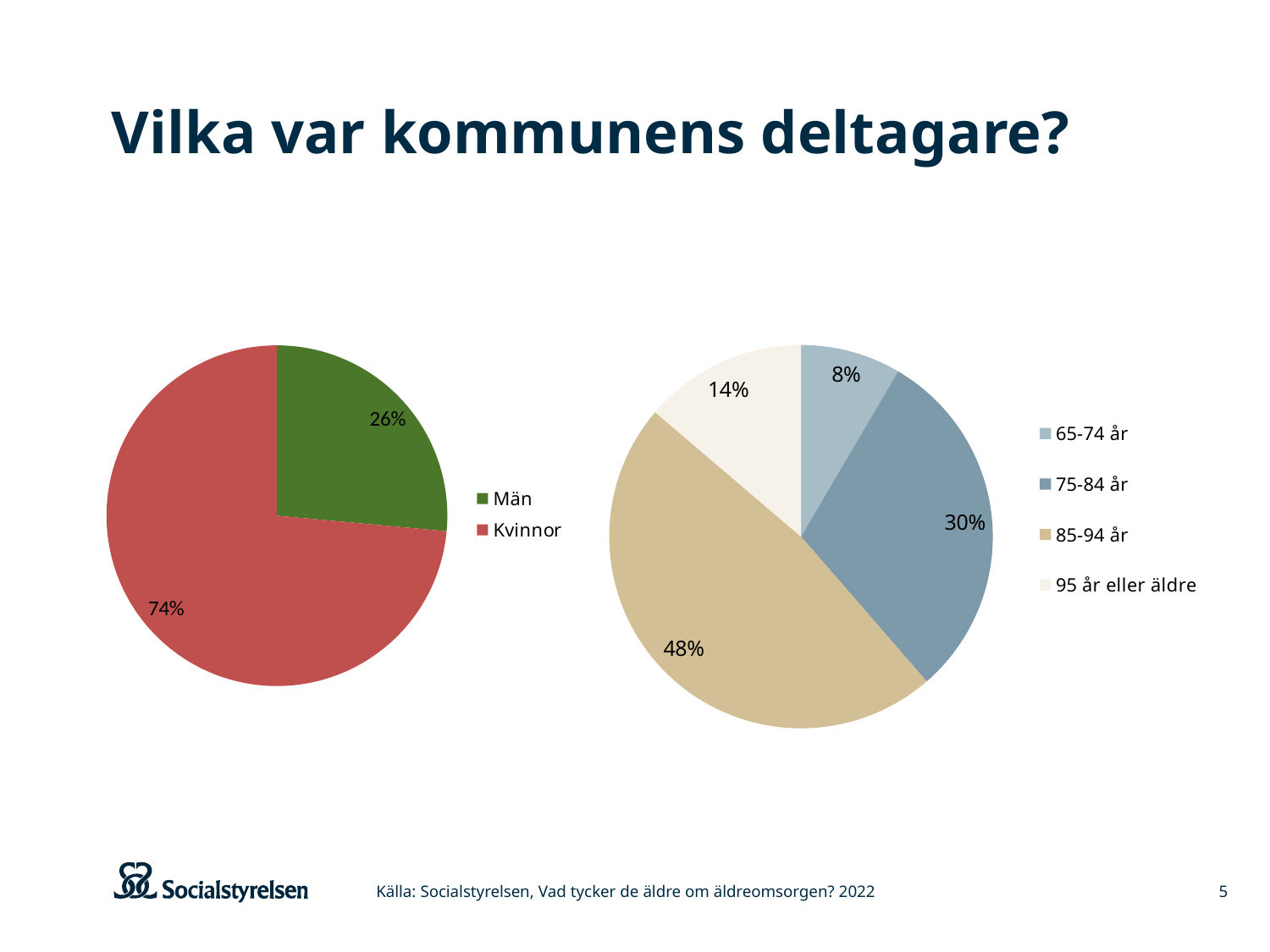
In the left pie chart, what share is labelled for Kvinnor? 74% In the right pie chart, which age group has the smallest share? 65-74 år In the right pie chart, what share is labelled for 65-74 år? 8% In the right pie chart, what share is labelled for 85-94 år? 48% In the right pie chart, how many age groups does the legend list? 4 In the left pie chart, which category has the larger share, Män or Kvinnor? Kvinnor What kind of chart is the left chart on the slide? Pie chart In the right pie chart, which age group has the largest share? 85-94 år In the left pie chart, what share is labelled for Män? 26% In the right pie chart, what is the difference in percentage points between 75-84 år and 95 år eller äldre? 16 In the right pie chart, what share is labelled for 95 år eller äldre? 14% In the left pie chart, what is the difference in percentage points between Kvinnor and Män? 48